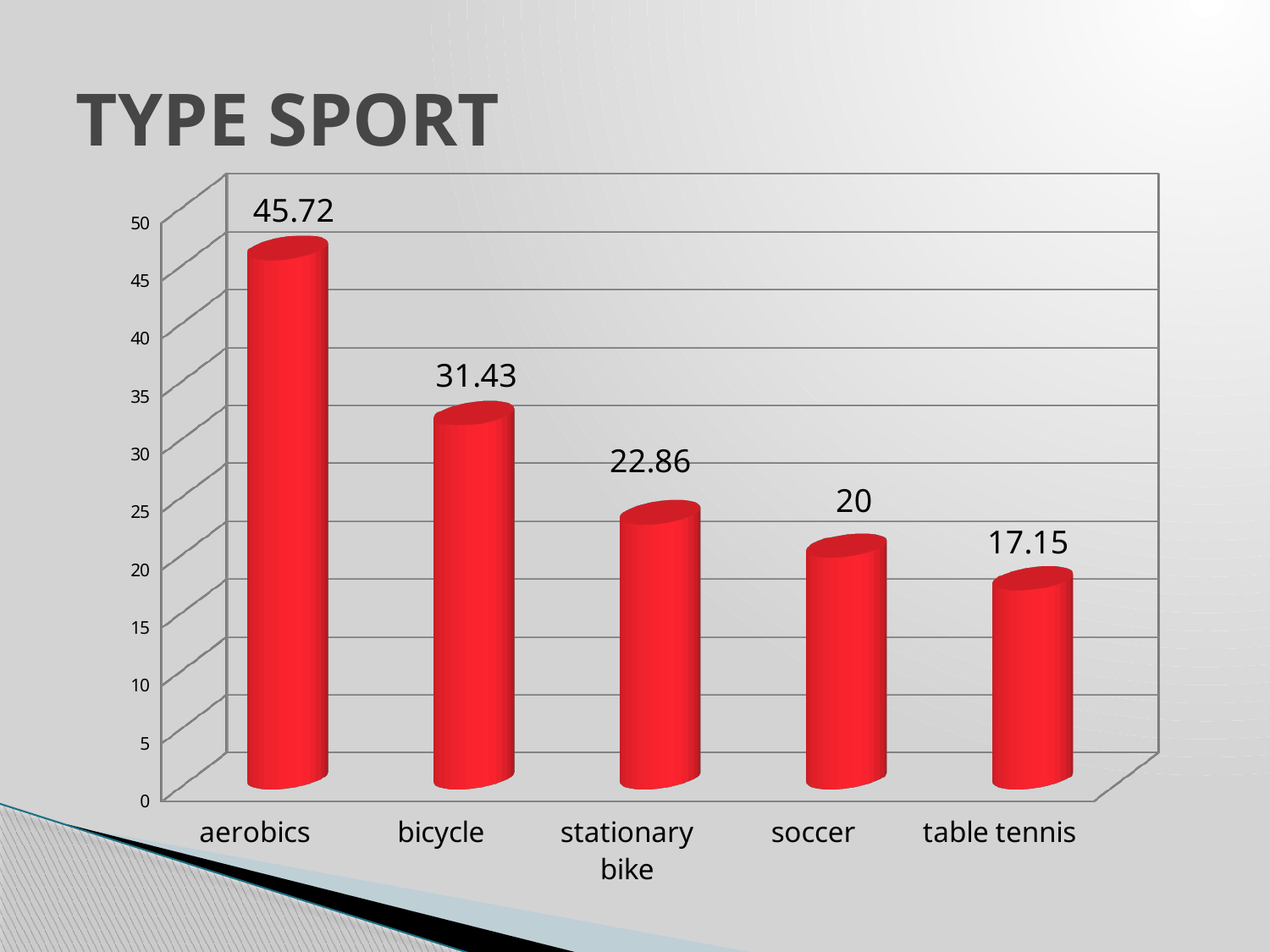
What is the value for table tennis? 17.15 What is the value for stationary bike? 22.86 Which is larger, the value for stationary bike or the value for soccer? stationary bike What kind of chart is shown on the slide? bar chart What is the difference between the values for soccer and table tennis? 2.85 Do the values rise or fall from left to right along the x axis? fall What is the value for aerobics? 45.72 What is the value for bicycle? 31.43 What is the difference between the values for aerobics and bicycle? 14.29 How many categories are shown on the chart? 5 Which category has the lowest value? table tennis Which category has the highest value? aerobics